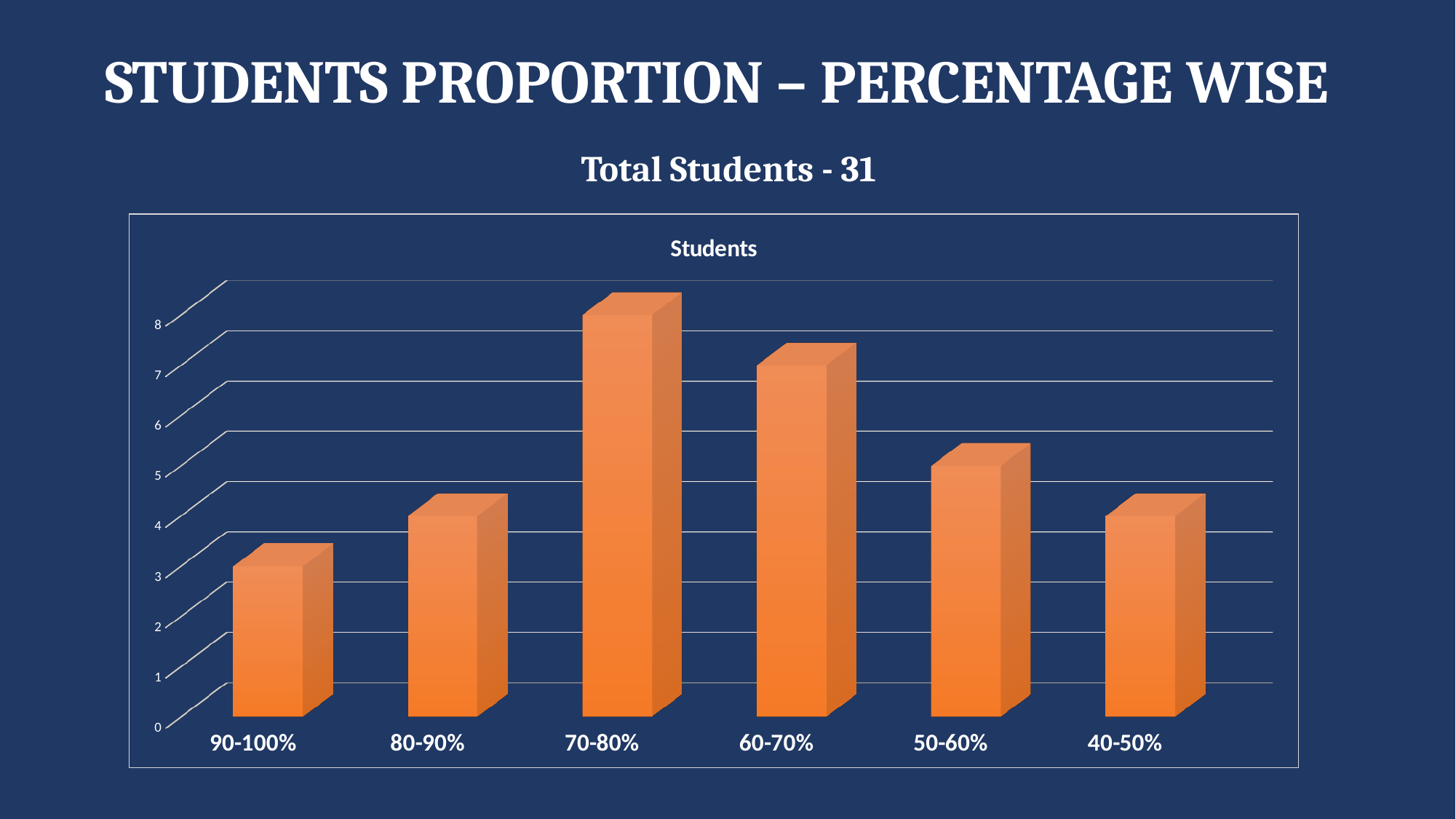
What is the title of the chart? Students Is the value for 90-100% greater or less than 4? less Which has more students, 70-80% or 80-90%? 70-80% Is the value for 70-80% greater or less than 6? greater Which has more students, 60-70% or 50-60%? 60-70% What total number of students is stated above the chart? 31 What kind of chart is shown on the slide? bar chart Is the value for 40-50% greater or less than 6? less How many percentage categories are shown on the x axis? 6 Which percentage category has the highest number of students? 70-80% Which percentage category has the lowest number of students? 90-100%